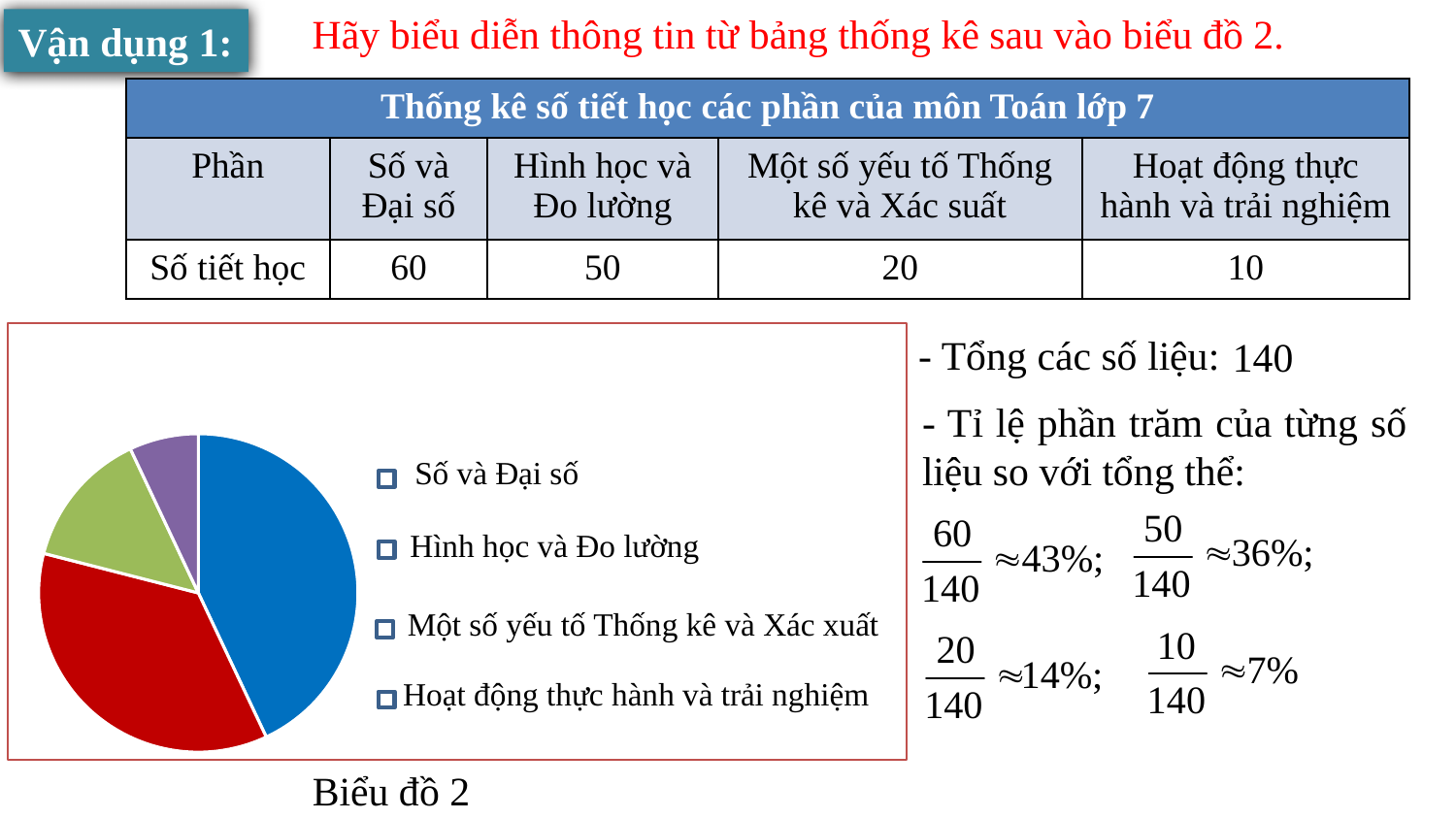
How many slices does the pie chart Biểu đồ 2 have? 4 Which has more lessons, Hình học và Đo lường or Hoạt động thực hành và trải nghiệm? Hình học và Đo lường How many entries does the legend of Biểu đồ 2 list? 4 What is the caption/title written under the pie chart? Biểu đồ 2 What colour is the largest slice of the pie chart Biểu đồ 2? blue What kind of chart is Biểu đồ 2? pie chart Which category has the largest slice in Biểu đồ 2? Số và Đại số How many lessons (số tiết học) are there for Hình học và Đo lường? 50 What is the total of all the values shown for Biểu đồ 2? 140 Which category has the smallest slice in Biểu đồ 2? Hoạt động thực hành và trải nghiệm How many lessons (số tiết học) are there for Một số yếu tố Thống kê và Xác suất? 20 What is the difference in lessons between Số và Đại số and Hình học và Đo lường? 10